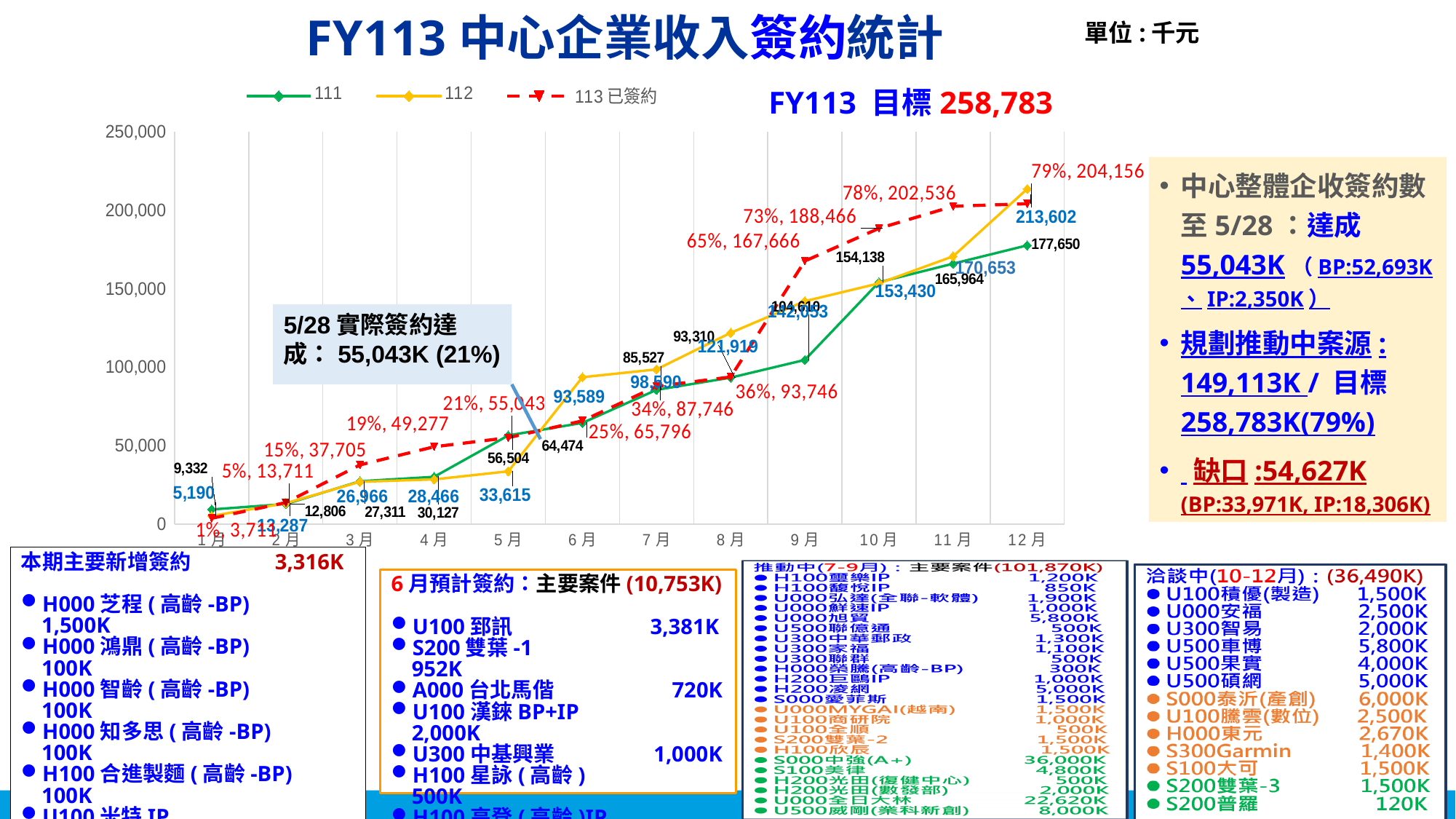
Does the 112 series generally rise or fall from 1月 to 12月? rise What is the value of the 112 series at 12月? 213,602 In which month does the 112 series reach its highest value? 12月 What kind of chart is shown on the slide? line chart How many months are plotted along the x axis of the chart? 12 What is the value of the 111 series at 1月? 9,332 What is the value of the 113 已簽約 series at 5月? 55,043 What is the difference between the 112 and 111 values at 12月? 35,952 What FY113 target value is printed above the chart? 258,783 At 5月, which series has the larger value, 111 or 112? 111 How many series does the chart legend list? 3 What is the value of the 111 series at 12月? 177,650